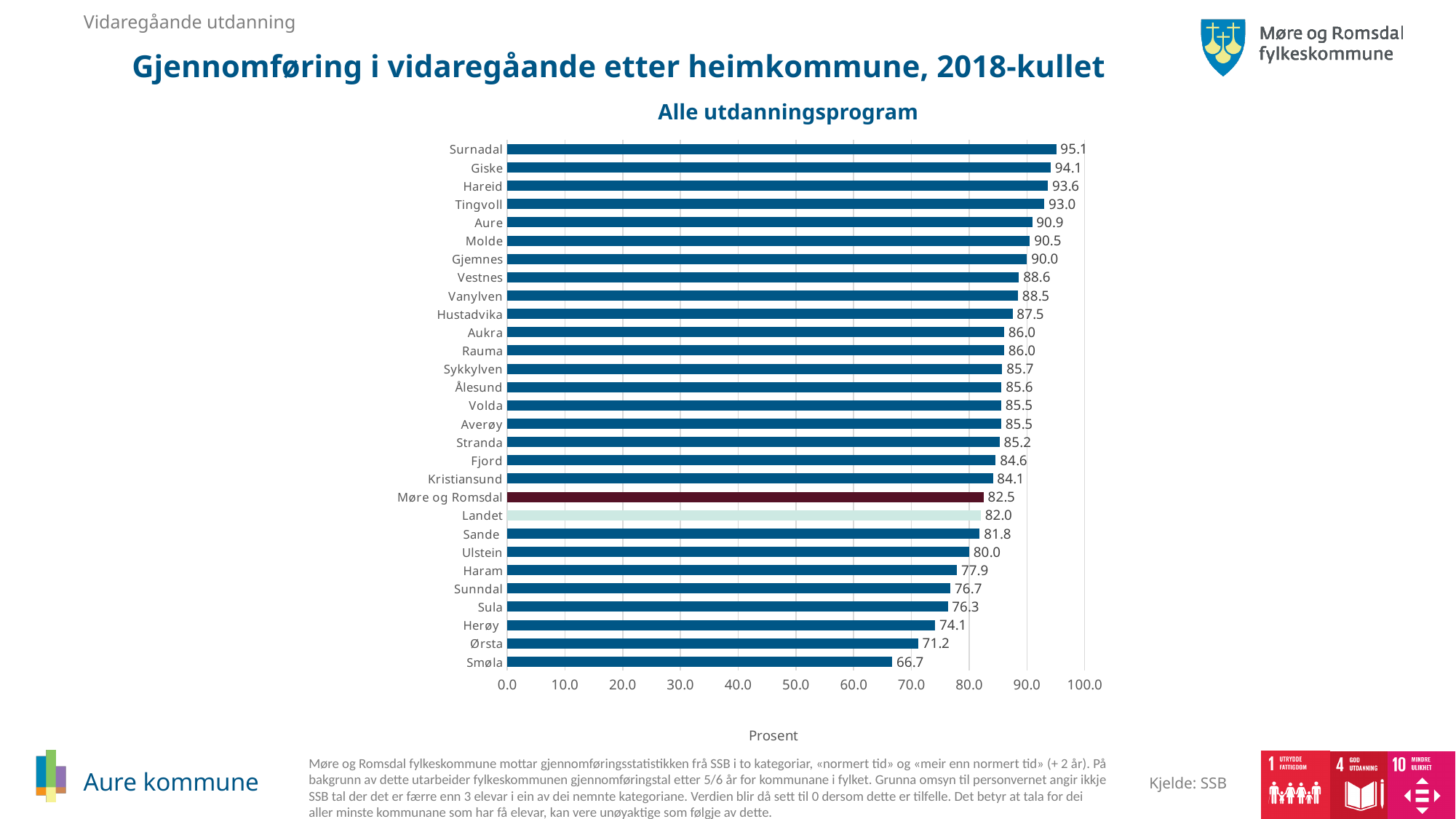
Which category has the highest value? Surnadal What is the title of the chart? Alle utdanningsprogram What is the difference between the values for Surnadal and Smøla? 28.4 What is the value for Aure? 90.9 What is the difference between the values for Aure and Landet? 8.9 Which category has the lowest value? Smøla What is the value for Landet? 82.0 Is the value for Ørsta greater or less than 80.0? less How many categories are shown on the chart? 29 Which is larger, the value for Molde or the value for Kristiansund? Molde What is the value for Møre og Romsdal? 82.5 What kind of chart is shown on the slide? bar chart